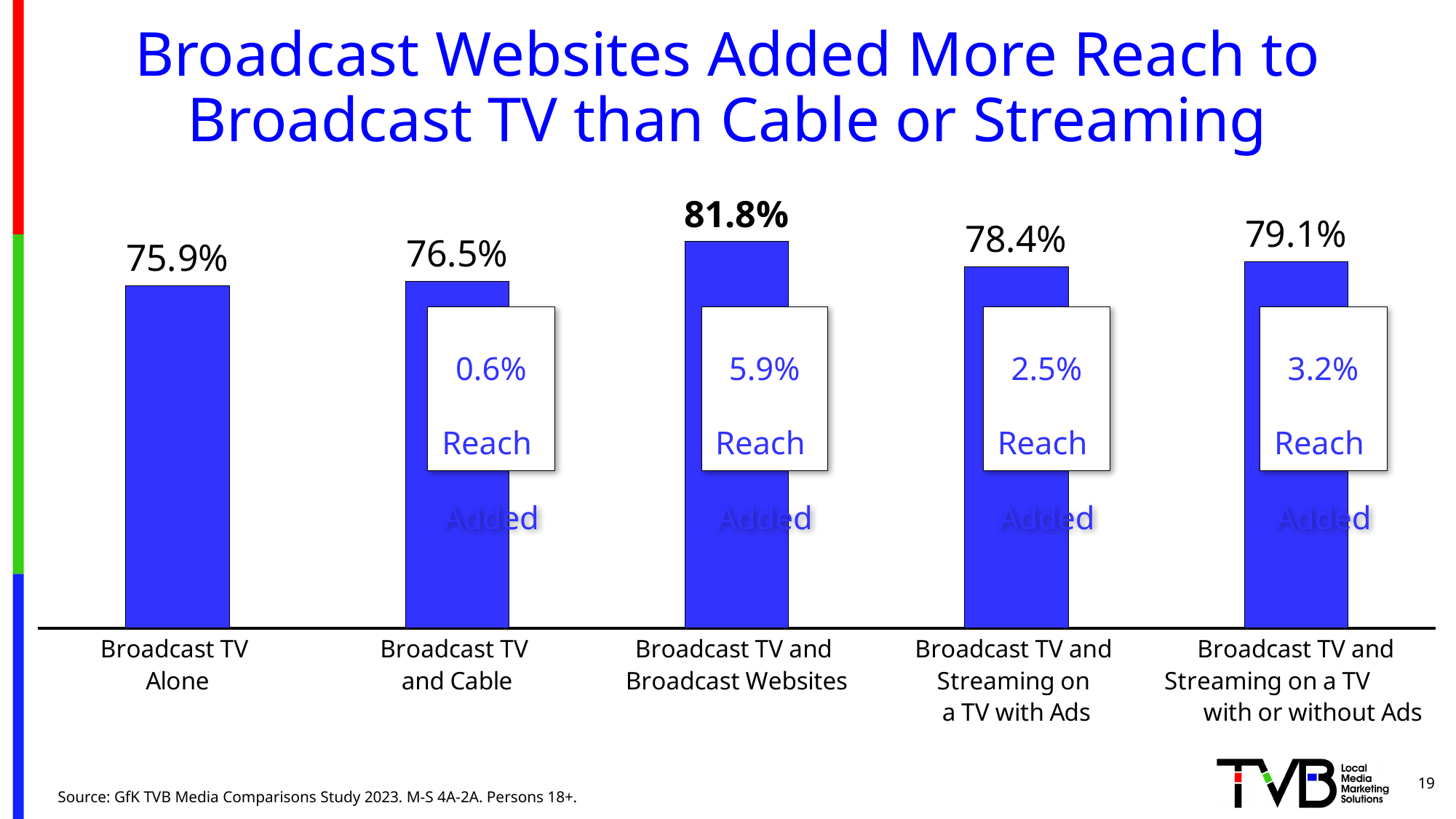
What is the reach value for Broadcast TV and Streaming on a TV with Ads? 78.4% What is the difference in reach between Broadcast TV and Broadcast Websites and Broadcast TV Alone? 5.9% What is the reach value for Broadcast TV and Streaming on a TV with or without Ads? 79.1% What is the reach value for Broadcast TV and Broadcast Websites? 81.8% Which category has the lowest reach? Broadcast TV Alone What is the reach value for Broadcast TV Alone? 75.9% Which has a larger reach: Broadcast TV and Cable or Broadcast TV and Streaming on a TV with Ads? Broadcast TV and Streaming on a TV with Ads What kind of chart is shown on the slide? Bar chart Which category has the highest reach? Broadcast TV and Broadcast Websites How much reach was added by Broadcast TV and Cable over Broadcast TV Alone, according to the label on the bar? 0.6% How many categories are shown in the chart? 5 What is the title of the slide? Broadcast Websites Added More Reach to Broadcast TV than Cable or Streaming